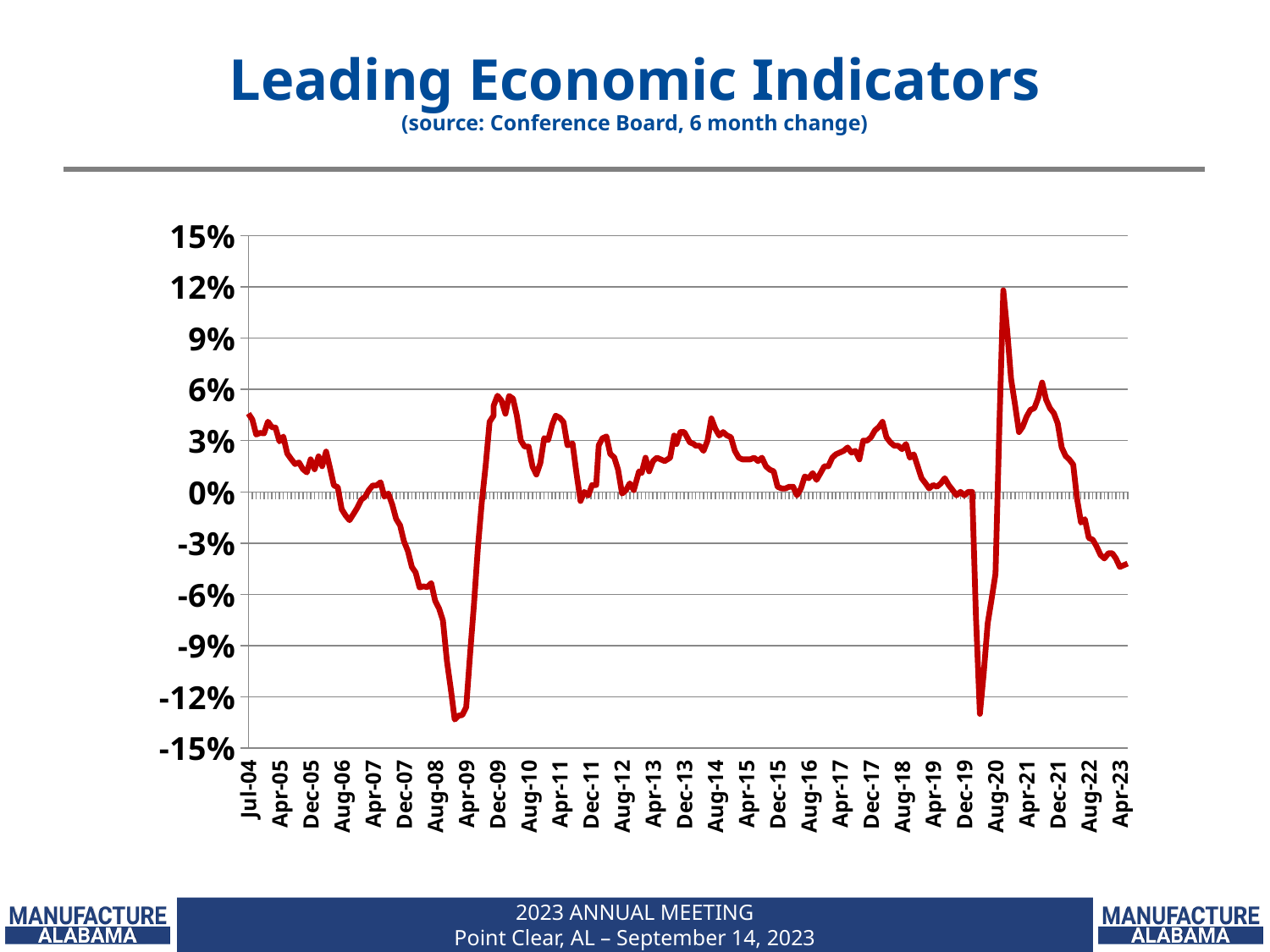
Near which x-axis label does the line reach its highest value? Aug-20 Is the value at Apr-23 greater or less than 0%? less Is the value at Dec-09 greater or less than 3%? greater Between Dec-21 and Apr-23, does the line generally rise or fall? fall What kind of chart is shown on the slide? line chart Is the value at Apr-21 greater or less than 3%? greater Is the value at Dec-09 higher or lower than the value at Apr-09? higher What is the title of the chart? Leading Economic Indicators According to the subtitle, what is the source of the data? Conference Board Is the value at Apr-23 higher or lower than the value at Apr-21? lower